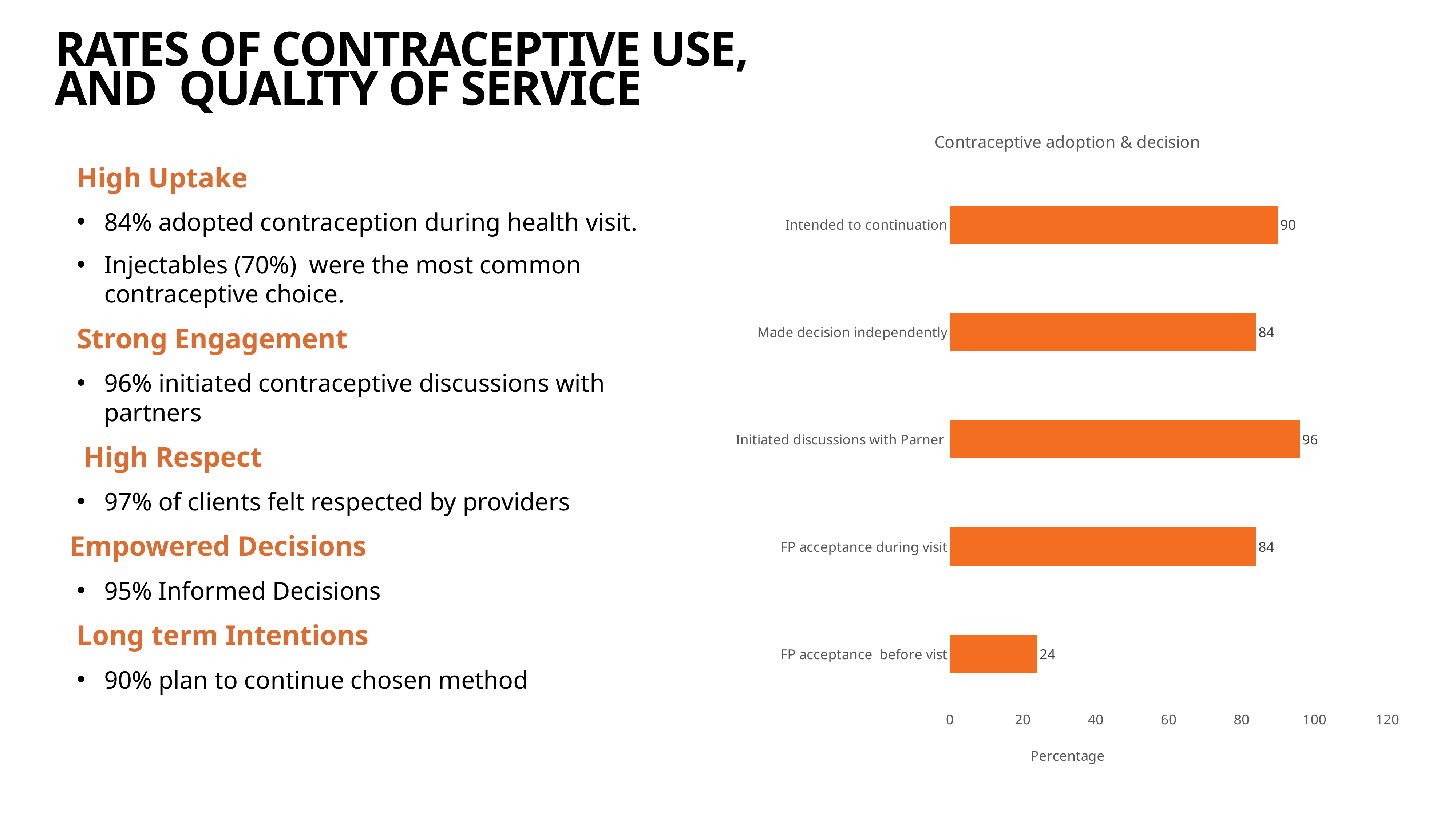
What is the value for 'Initiated discussions with Parner' in the chart? 96 What is the label of the horizontal axis of the chart? Percentage What kind of chart is shown on the slide? Bar chart What is the difference between 'FP acceptance during visit' and 'FP acceptance before vist'? 60 Which category has the highest value in the chart? Initiated discussions with Parner What is the title of the chart? Contraceptive adoption & decision What is the value for 'Intended to continuation' in the chart? 90 What is the value for 'FP acceptance before vist' in the chart? 24 What is the value for 'Made decision independently' in the chart? 84 Which category has the lowest value in the chart? FP acceptance before vist How many categories are shown in the chart? 5 Which is larger: 'Intended to continuation' or 'Made decision independently'? Intended to continuation